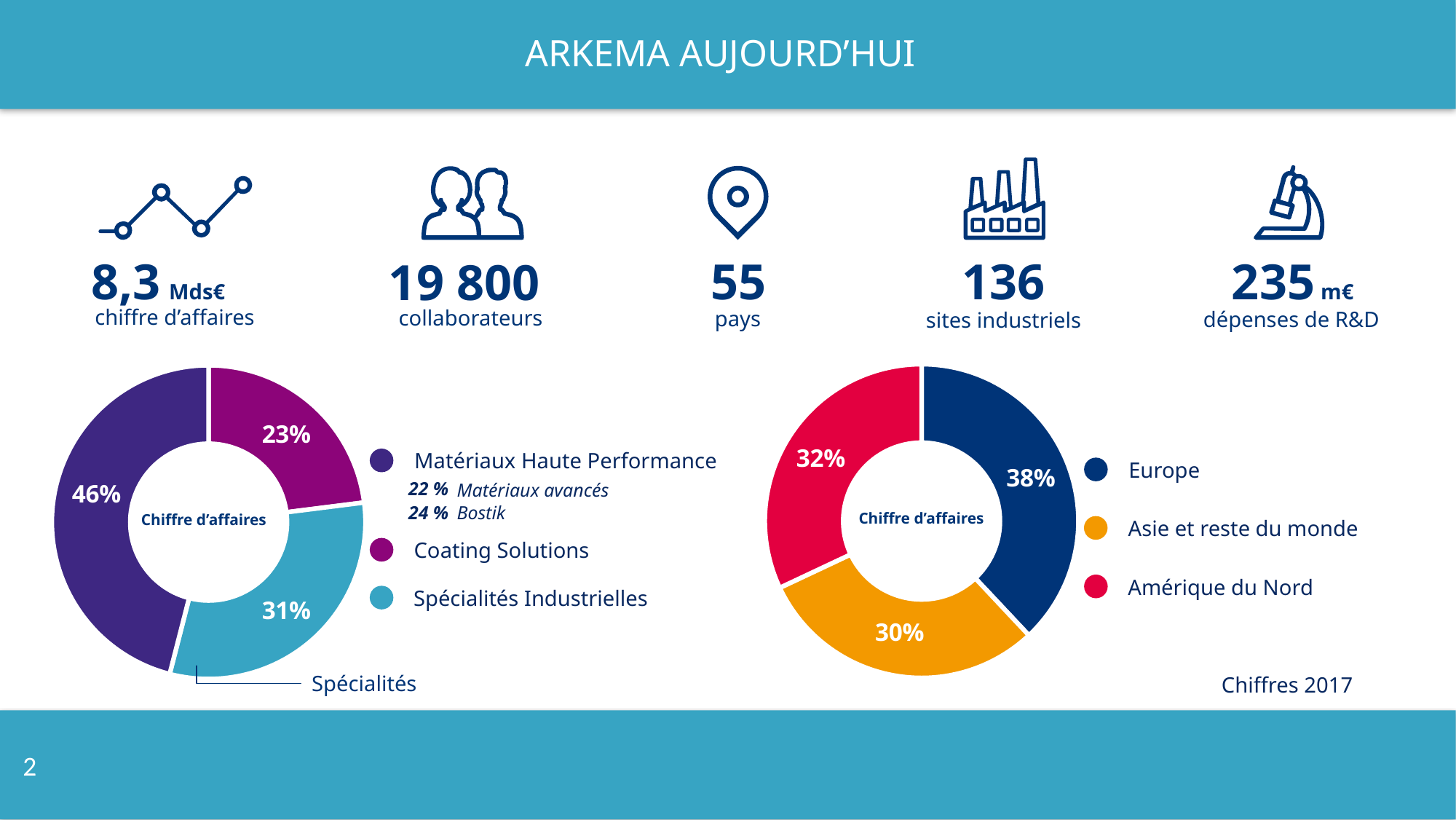
In the right donut chart, which is larger, the share for Amérique du Nord or for Asie et reste du monde? Amérique du Nord In the right donut chart, what colour represents Amérique du Nord? Red What type of chart is used on the right side of the slide? Donut (pie) chart In the right donut chart, which region has the largest share? Europe In the left donut chart, what is the difference between the shares of Matériaux Haute Performance and Spécialités Industrielles? 15 percentage points In the right donut chart, what share of chiffre d'affaires comes from Asie et reste du monde? 30% In the left donut chart, what share of chiffre d'affaires comes from Matériaux Haute Performance? 46% In the left donut chart, what share of chiffre d'affaires comes from Coating Solutions? 23% In the left donut chart, which segment has the largest share? Matériaux Haute Performance In the left donut chart, how many segments are shown? 3 In the right donut chart, what share of chiffre d'affaires comes from Europe? 38% In the left donut chart, which segment has the smallest share? Coating Solutions